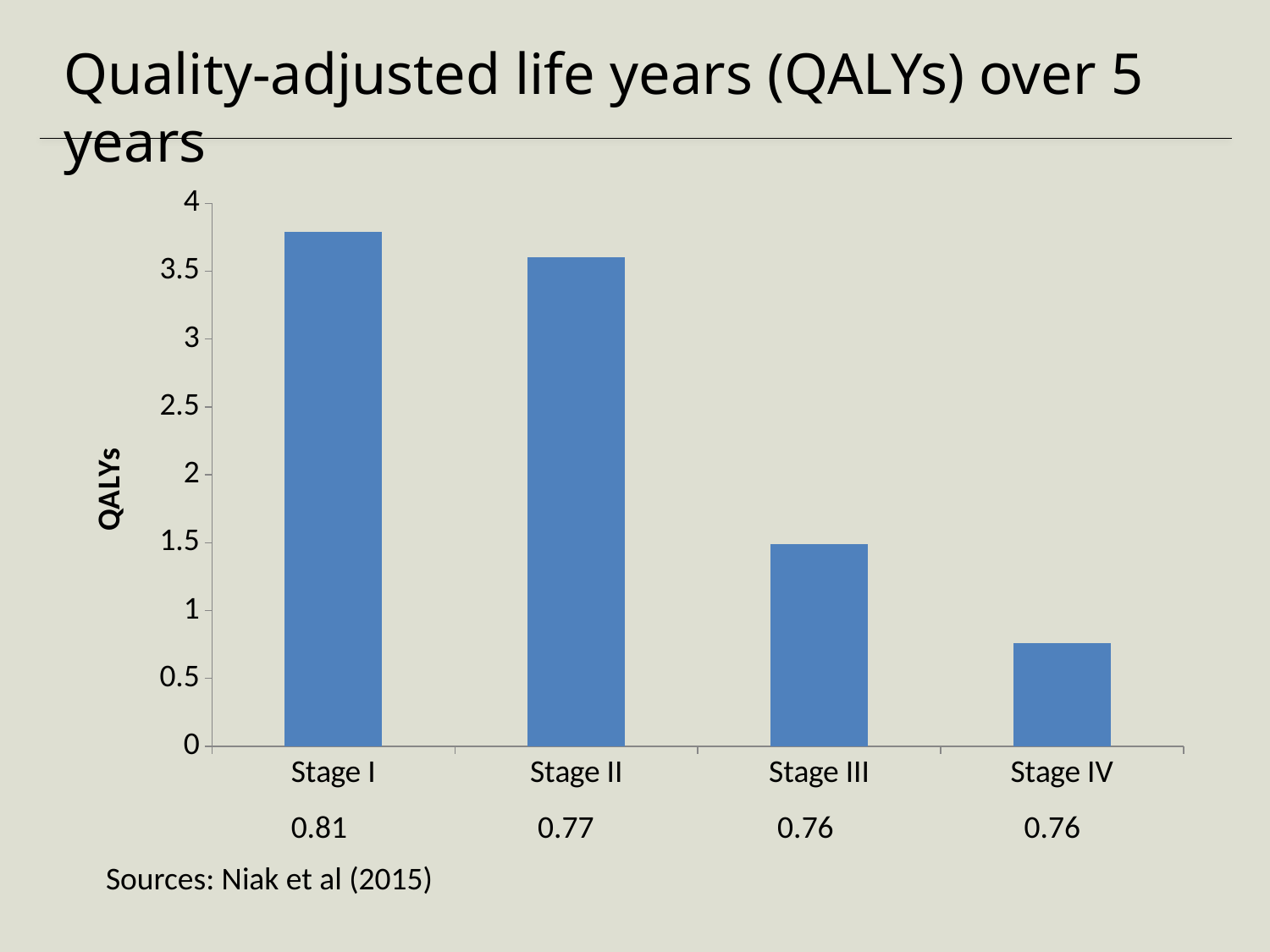
Which stage has the highest QALYs value? Stage I Is the QALYs value for Stage III greater or less than 2? less Which has a larger QALYs value, Stage III or Stage IV? Stage III What kind of chart is shown on the slide? bar chart Do the QALYs values rise or fall from Stage I to Stage IV? fall Which has a larger QALYs value, Stage II or Stage III? Stage II Is the QALYs value for Stage II greater or less than 3? greater Which stage has the lowest QALYs value? Stage IV How many stages are shown on the x axis of the chart? 4 Is the QALYs value for Stage IV greater or less than 1? less What is the label on the vertical axis of the chart? QALYs